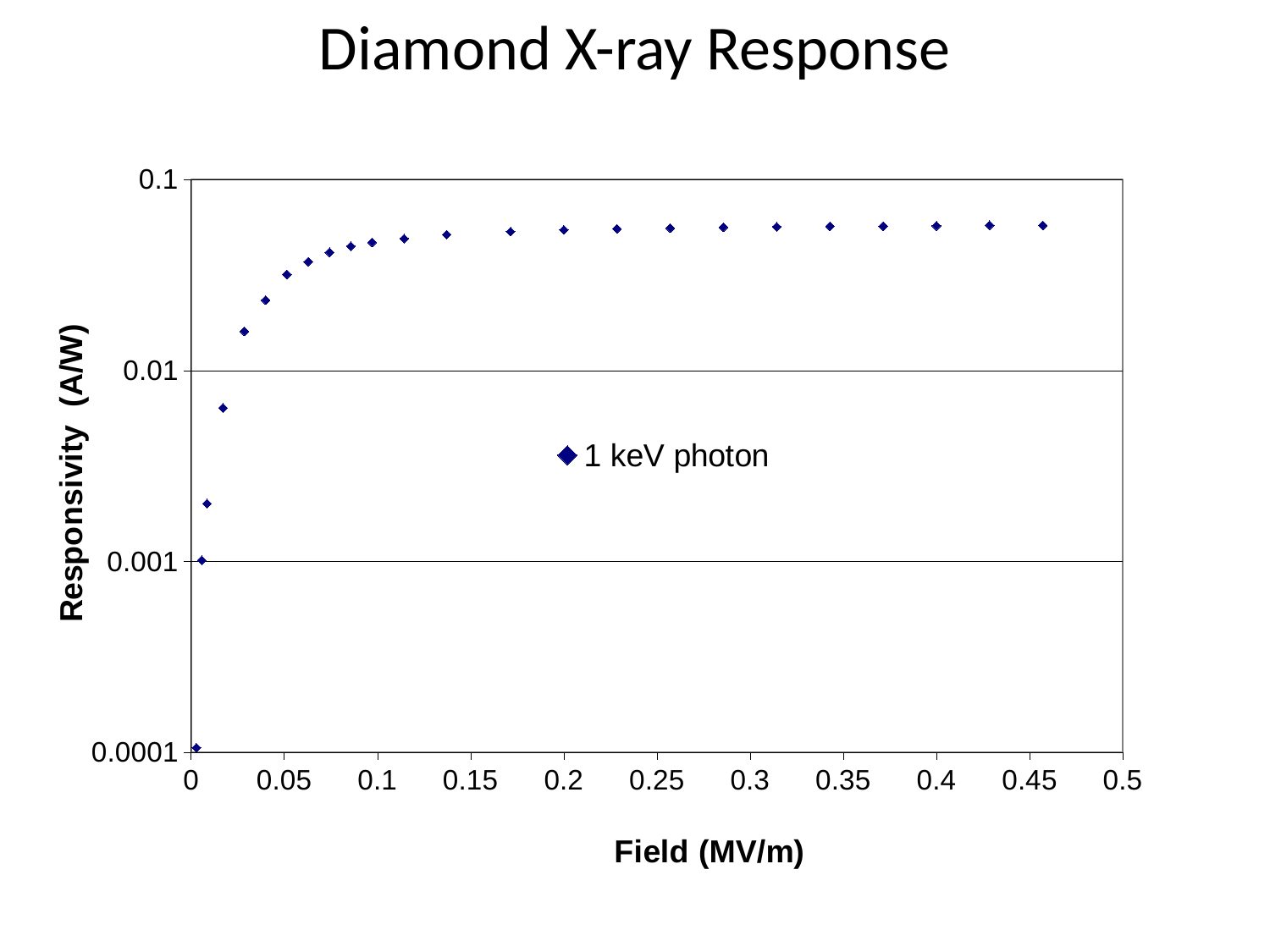
What is the legend entry for the plotted series? 1 keV photon Is the responsivity at a field of 0.2 MV/m greater or less than 0.01 A/W? greater What is the title of the y axis? Responsivity (A/W) Is the responsivity at a field of 0.05 MV/m greater or less than 0.01 A/W? greater Which has the larger responsivity: a field of 0.1 MV/m or a field of 0.02 MV/m? 0.1 MV/m How many series does the legend list? 1 Is the responsivity at a field of about 0.007 MV/m greater or less than 0.01 A/W? less What kind of chart is shown on the slide? scatter chart Does the responsivity rise or fall as the field increases from 0 to 0.1 MV/m? rise